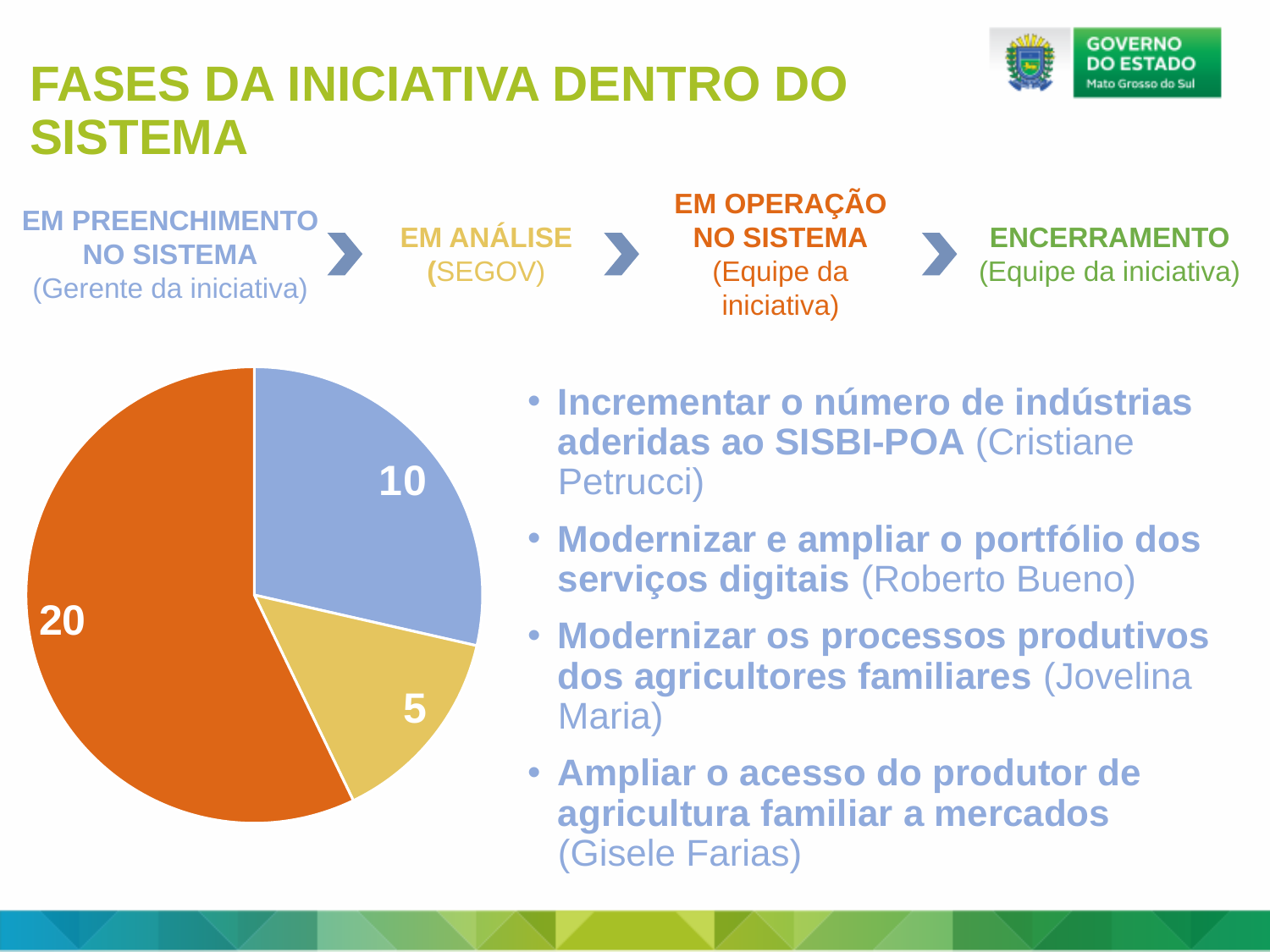
What is the difference between the largest and smallest slice values in the pie chart? 15 What colour is the largest slice of the pie chart? orange What is the largest value shown on the pie chart? 20 By how much does the orange slice's value exceed the blue slice's value? 10 Which slice has the larger value, the blue slice or the yellow slice? the blue slice What value is labelled on the blue slice of the pie chart? 10 What is the smallest value shown on the pie chart? 5 What is the total of all the values shown on the pie chart? 35 What kind of chart is shown on the slide? pie chart What value is labelled on the orange slice of the pie chart? 20 What value is labelled on the yellow slice of the pie chart? 5 How many slices does the pie chart have? 3